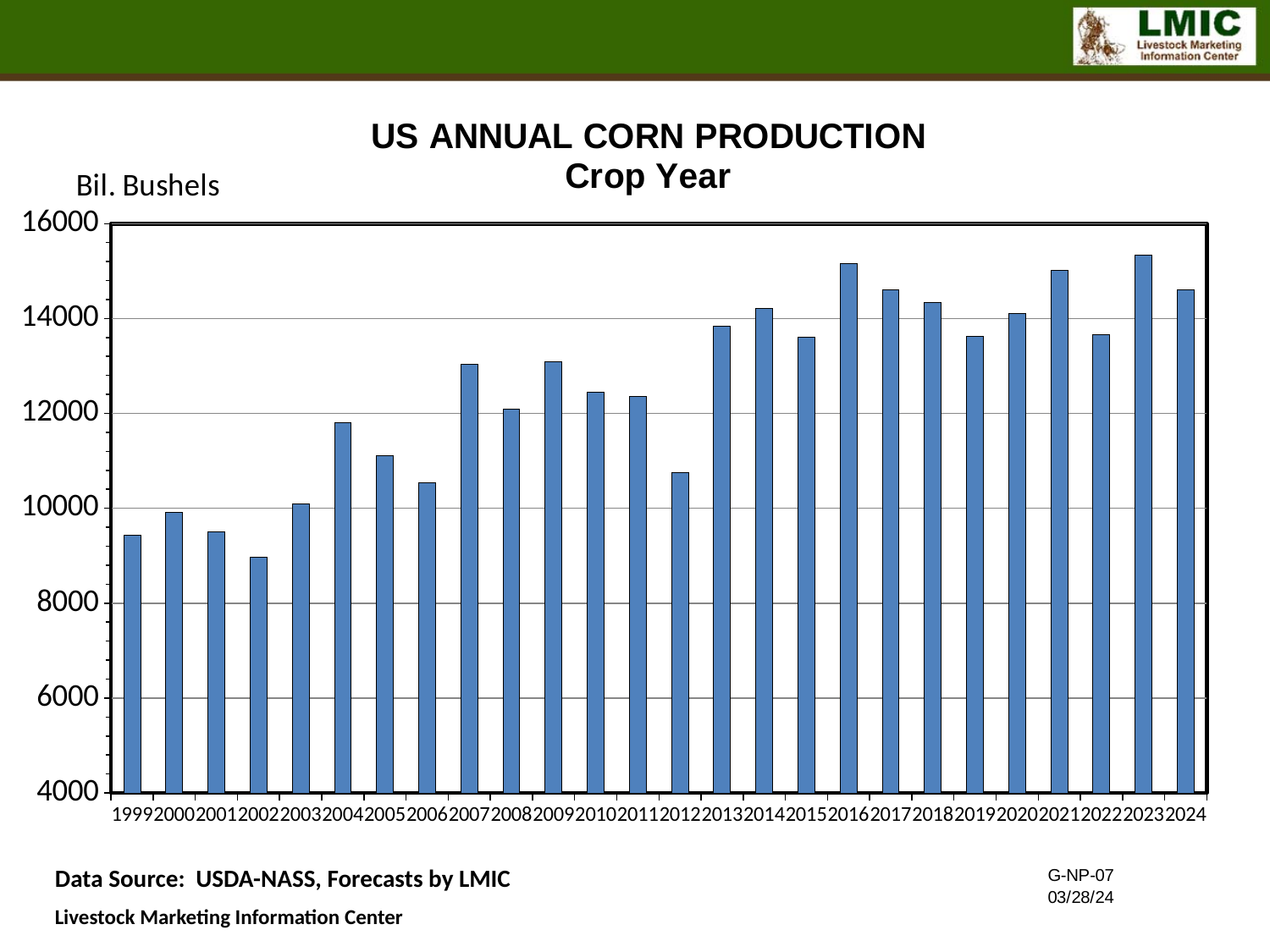
Is the value for 2019 greater or less than 14000? less Is the value for 2012 greater or less than 12000? less Which is larger, the value for 2016 or the value for 2019? 2016 Is the value for 2002 greater or less than 10000? less What unit is shown on the vertical axis label? Bil. Bushels Overall, do the values rise or fall from 1999 to 2024? rise Which is larger, the value for 2012 or the value for 2013? 2013 How many crop years are plotted on the chart? 26 What kind of chart is shown on the slide? bar chart Which crop year has the lowest corn production on the chart? 2002